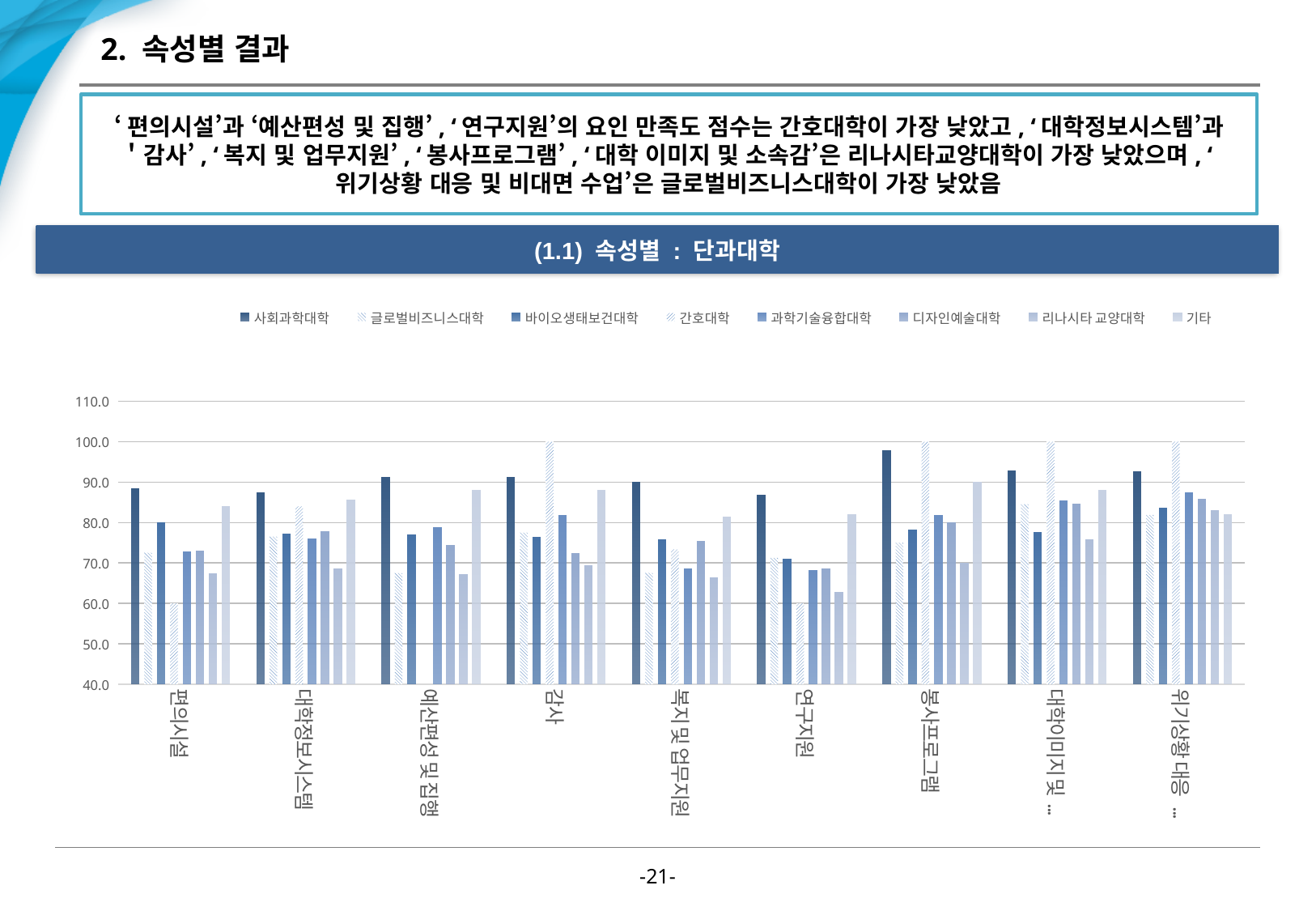
Which series has the highest value for 감사? 간호대학 How many categories are shown along the x axis? 9 What is the title shown in the banner above the chart? (1.1) 속성별 : 단과대학 Which series is listed first in the legend? 사회과학대학 Is the value for 리나시타 교양대학 at 연구지원 greater or less than 70? less Is the value for 사회과학대학 at 봉사프로그램 greater or less than 90? greater How many series does the legend list? 8 For 편의시설, which is larger: the value for 사회과학대학 or the value for 바이오생태보건대학? 사회과학대학 Which series has the lowest value for 대학정보시스템? 리나시타 교양대학 Which series has the lowest value for 편의시설? 간호대학 What kind of chart is shown on the slide? bar chart